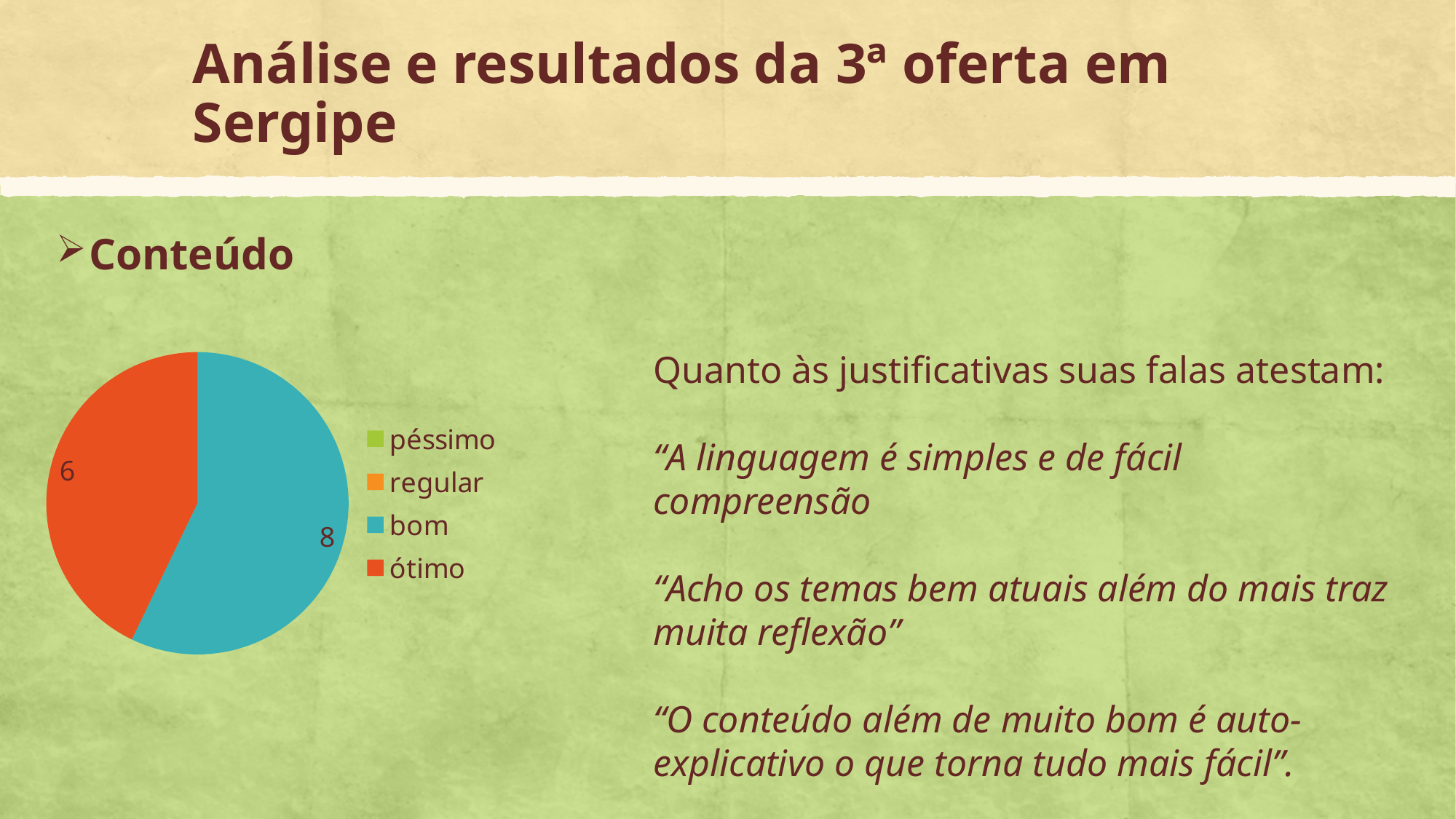
Which is larger in the pie chart, "bom" or "ótimo"? bom What kind of chart is shown on the slide? pie chart How many categories does the legend of the pie chart list? 4 What value is shown for the "bom" slice of the pie chart? 8 Which category has the largest slice in the pie chart? bom How many slices with data labels are visible in the pie chart? 2 Which colour represents "ótimo" in the pie chart? orange-red What is the difference between the "bom" and "ótimo" values in the pie chart? 2 What value is shown for the "ótimo" slice of the pie chart? 6 Which colour represents "bom" in the pie chart? blue